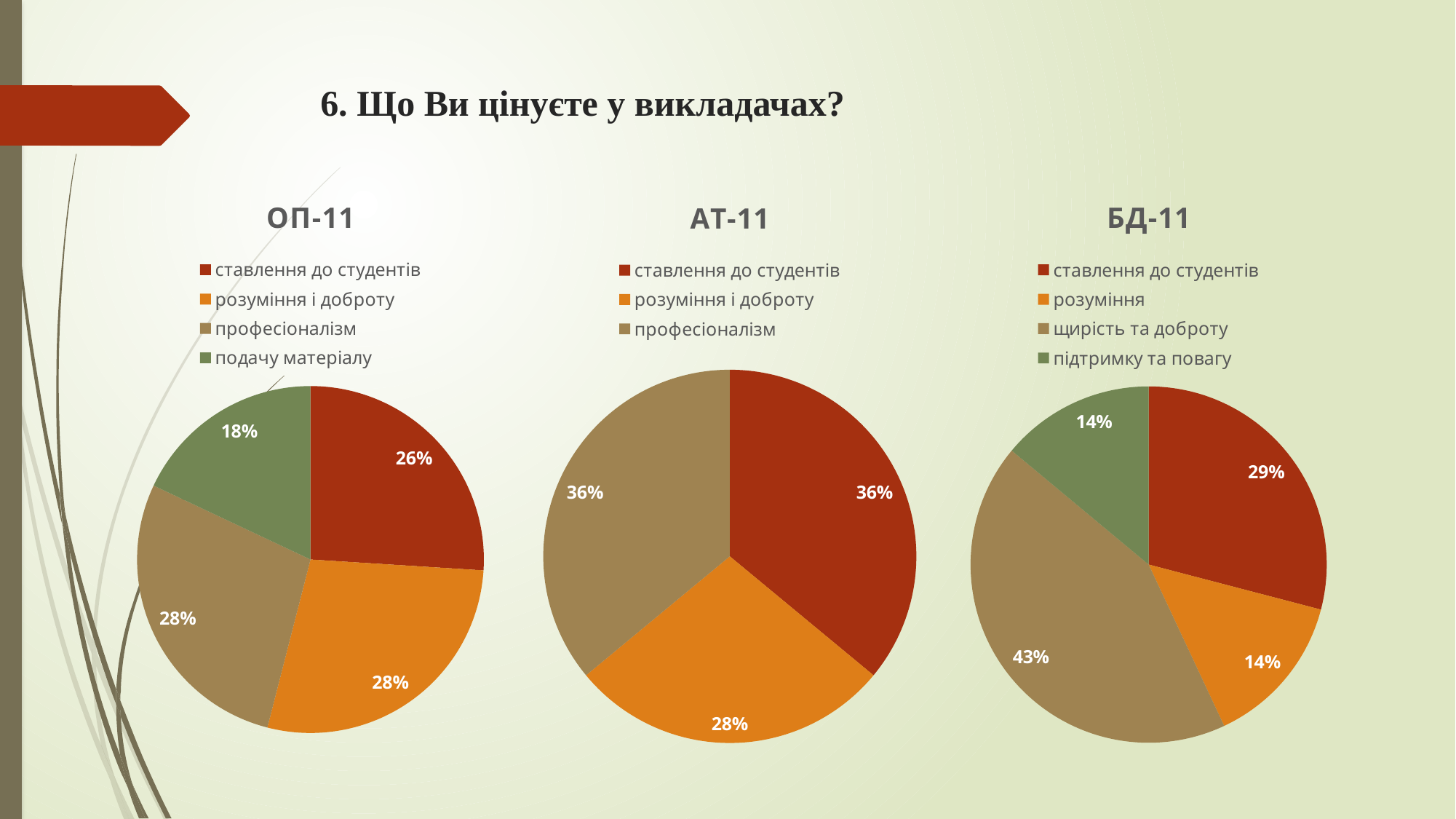
What type of chart is used for АТ-11? pie chart In the ОП-11 chart, which category has the smallest slice? подачу матеріалу In the ОП-11 chart, what share is labelled for ставлення до студентів? 26% In the БД-11 chart, which is larger: the share for ставлення до студентів or the share for розуміння? ставлення до студентів How many slices does the ОП-11 pie chart have? 4 In the АТ-11 chart, which category has the smallest slice? розуміння і доброту In the ОП-11 chart, what is the difference between the shares for розуміння і доброту and подачу матеріалу? 10% In the БД-11 chart, what share is labelled for ставлення до студентів? 29% In the АТ-11 chart, what share is labelled for розуміння і доброту? 28% In the БД-11 chart, which category has the largest slice? щирість та доброту In the БД-11 chart, what colour is the slice for підтримку та повагу? green How many entries does the legend of the АТ-11 chart list? 3